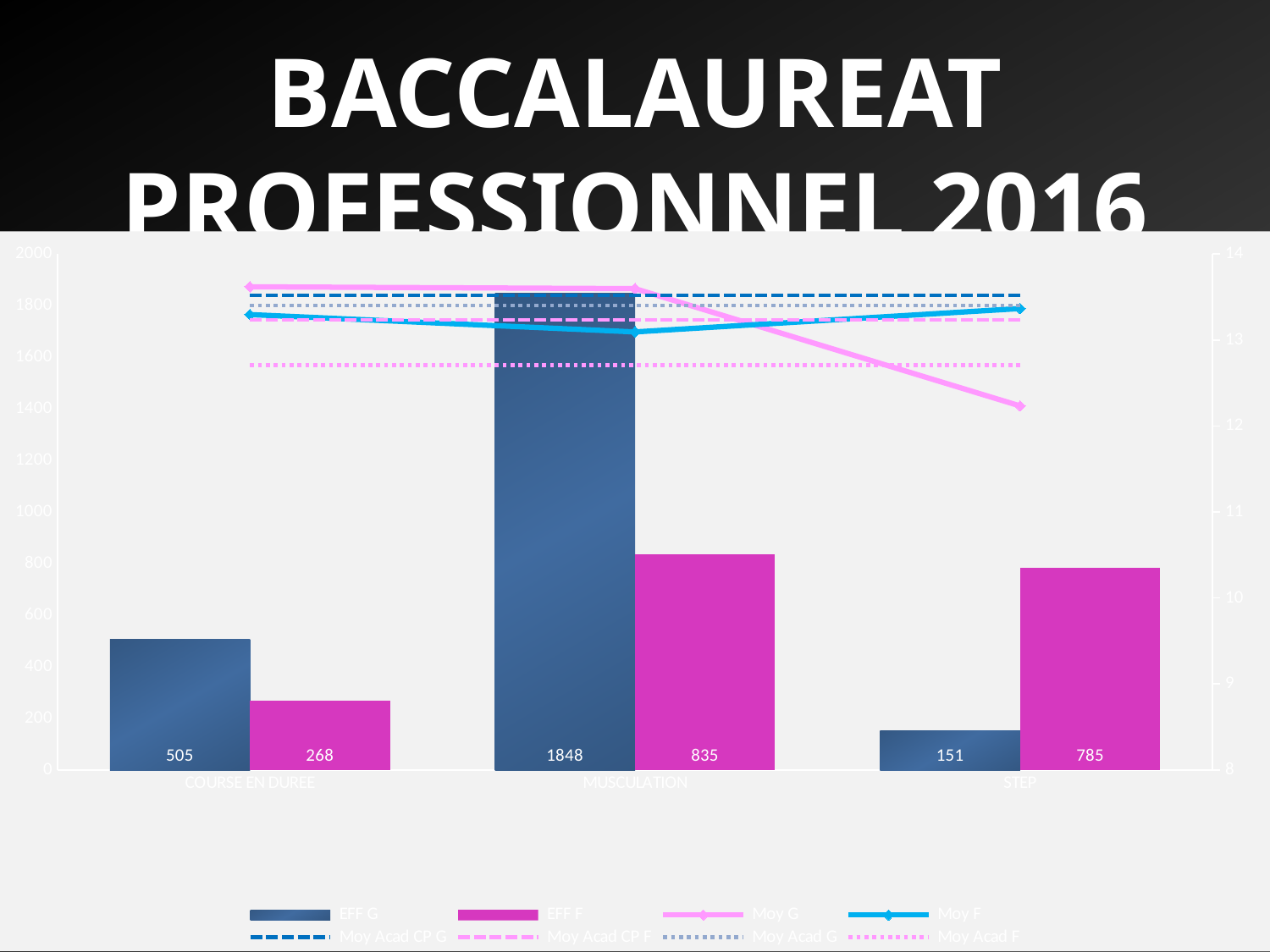
What is the EFF F value for STEP? 785 Which category has the highest EFF G value? MUSCULATION Does the Moy G line rise or fall from MUSCULATION to STEP? fall Which is larger for STEP, EFF G or EFF F? EFF F What is the EFF G value for COURSE EN DUREE? 505 What is the EFF G value for MUSCULATION? 1848 How many series does the legend list? 8 What is the title of the slide? BACCALAUREAT PROFESSIONNEL 2016 Is the EFF F value for COURSE EN DUREE greater or less than 400? less Which category has the lowest EFF F value? COURSE EN DUREE How many categories are shown on the x axis? 3 What is the difference between the EFF G and EFF F values for MUSCULATION? 1013